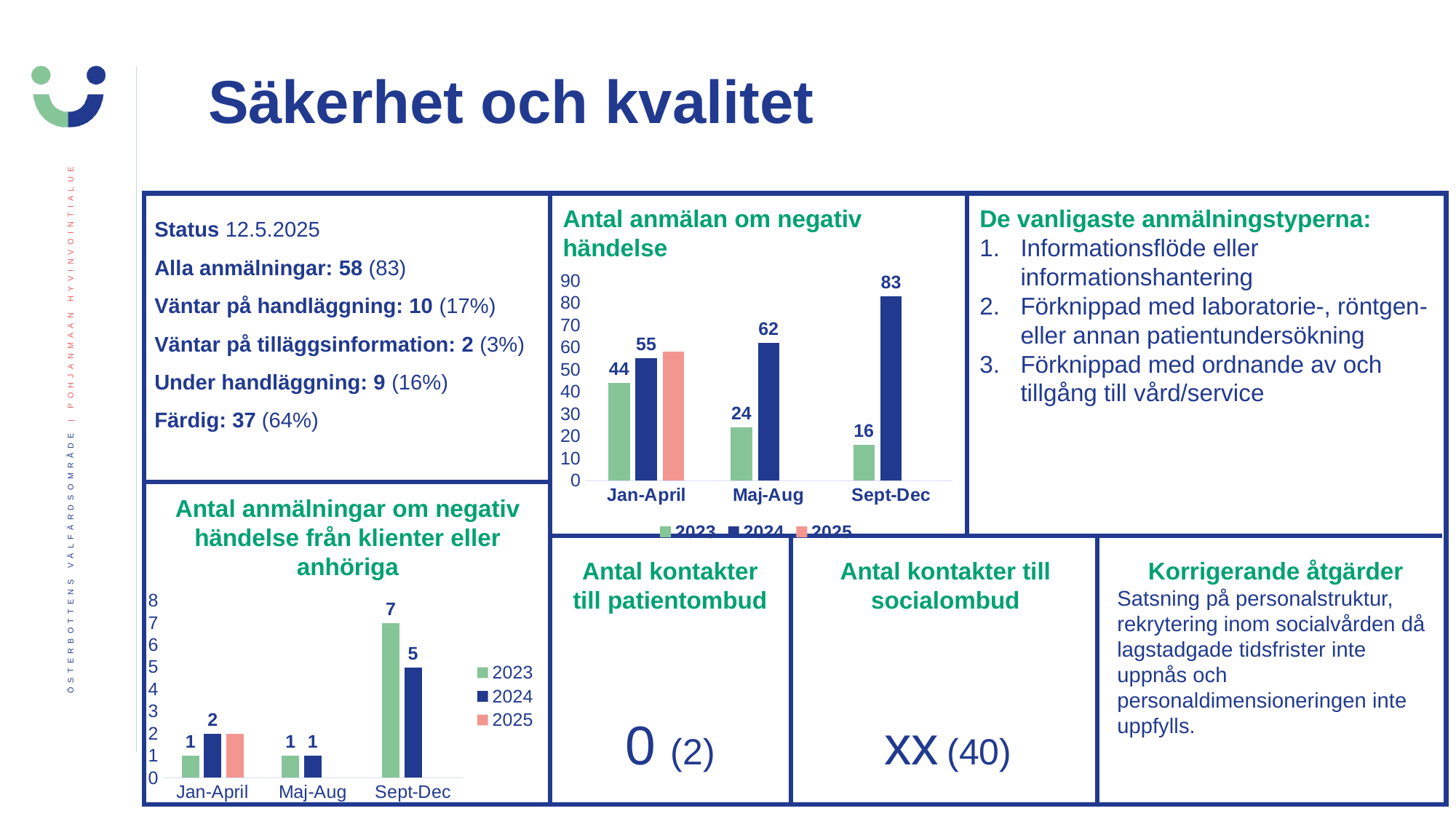
In the chart 'Antal anmälan om negativ händelse', what is the difference between the 2024 and 2023 values in Jan-April? 11 In the chart 'Antal anmälningar om negativ händelse från klienter eller anhöriga', what is the value for 2023 in Sept-Dec? 7 In the chart 'Antal anmälan om negativ händelse', do the 2023 values rise or fall from Jan-April to Sept-Dec? fall In the chart 'Antal anmälan om negativ händelse', which period has the lowest value for the 2023 series? Sept-Dec What kind of chart is 'Antal anmälningar om negativ händelse från klienter eller anhöriga'? bar chart How many series does the legend of the chart 'Antal anmälan om negativ händelse' list? 3 In the chart 'Antal anmälan om negativ händelse', which period has the highest value for the 2024 series? Sept-Dec How many periods are shown on the x axis of the chart 'Antal anmälningar om negativ händelse från klienter eller anhöriga'? 3 In the chart 'Antal anmälan om negativ händelse', what is the value for 2023 in Maj-Aug? 24 In the chart 'Antal anmälan om negativ händelse', what is the value for 2024 in Sept-Dec? 83 In the chart 'Antal anmälningar om negativ händelse från klienter eller anhöriga', which is larger in Sept-Dec, the 2023 value or the 2024 value? 2023 In the chart 'Antal anmälan om negativ händelse', is the 2025 value for Jan-April greater or less than 50? greater